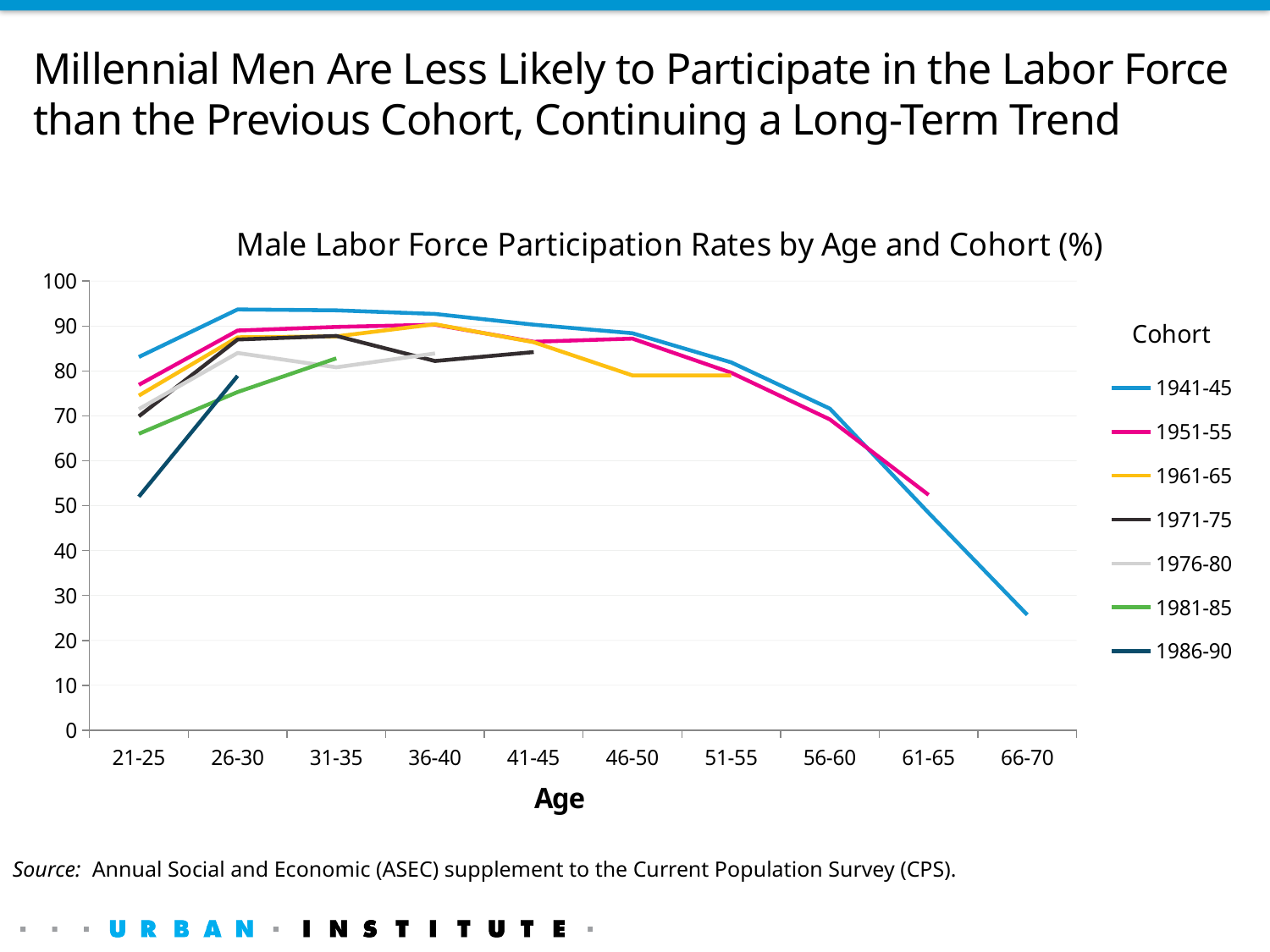
What kind of chart is shown on the slide? Line chart Is the value for the 1941-45 cohort at age 66-70 greater or less than 30? less Does the 1941-45 cohort's line rise or fall from age 46-50 to age 66-70? Falls At age 46-50, which cohort has the higher value: 1951-55 or 1961-65? 1951-55 How many age groups are shown along the x axis? 10 How many cohorts does the legend list? 7 At age 21-25, which cohort has the lowest labor force participation rate? 1986-90 Is the value for the 1941-45 cohort at age 26-30 greater or less than 90? greater Is the value for the 1981-85 cohort at age 21-25 greater or less than 70? less At age 21-25, which cohort has the highest labor force participation rate? 1941-45 What is the title of the legend on the chart? Cohort